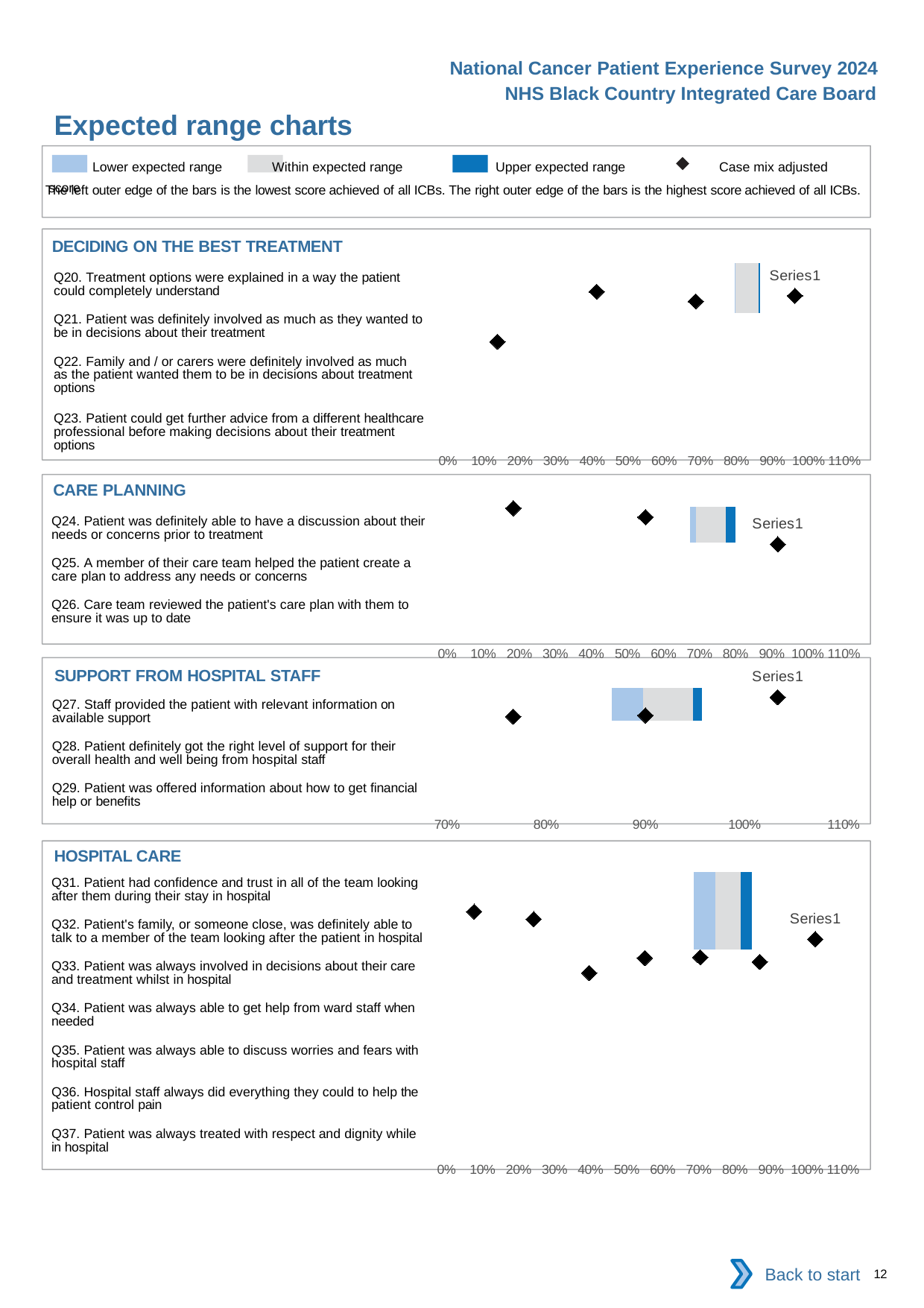
How many questions (categories) are listed in the DECIDING ON THE BEST TREATMENT chart? 4 What is the highest axis tick shown on the CARE PLANNING chart? 110% How many questions (categories) are listed in the SUPPORT FROM HOSPITAL STAFF chart? 3 What is the name of the series shown in the legend of the HOSPITAL CARE chart? Series1 How many series does the legend of the CARE PLANNING chart list? 1 What is the title of the first (top) chart section? DECIDING ON THE BEST TREATMENT How many charts are shown on the slide? 4 In the DECIDING ON THE BEST TREATMENT chart, is the lowest plotted marker greater or less than 20%? less In the CARE PLANNING chart, is the highest plotted marker greater or less than 80%? greater In the HOSPITAL CARE chart, is the highest plotted marker greater or less than 90%? greater What is the lowest axis tick shown on the SUPPORT FROM HOSPITAL STAFF chart? 70%